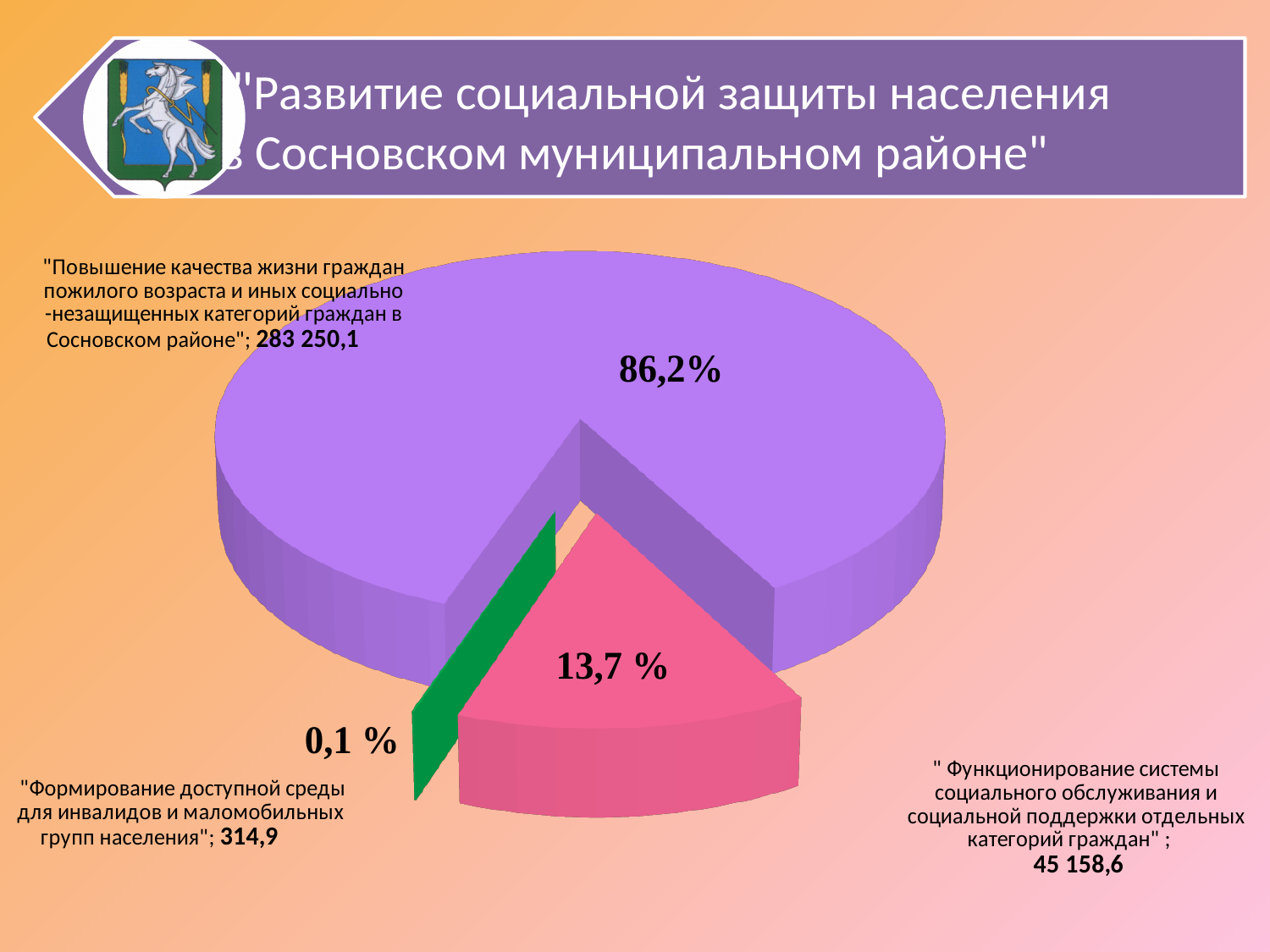
How many slices does the pie chart have? 3 Which category has the largest slice of the pie? "Повышение качества жизни граждан пожилого возраста и иных социально-незащищенных категорий граждан в Сосновском районе" What is the value for "Повышение качества жизни граждан пожилого возраста и иных социально-незащищенных категорий граждан в Сосновском районе"? 283 250,1 What is the value for "Формирование доступной среды для инвалидов и маломобильных групп населения"? 314,9 What kind of chart is shown on the slide? Pie chart Which category has the smallest slice of the pie? "Формирование доступной среды для инвалидов и маломобильных групп населения" What share of the pie does the "Повышение качества жизни граждан пожилого возраста..." slice represent? 86,2% What is the difference between the values for "Повышение качества жизни граждан пожилого возраста..." and "Функционирование системы социального обслуживания..."? 238 091,5 What share of the pie does the "Формирование доступной среды для инвалидов..." slice represent? 0,1 % What is the value for "Функционирование системы социального обслуживания и социальной поддержки отдельных категорий граждан"? 45 158,6 What share of the pie does the "Функционирование системы социального обслуживания..." slice represent? 13,7 % What colour is the slice labelled 13,7 %? Pink